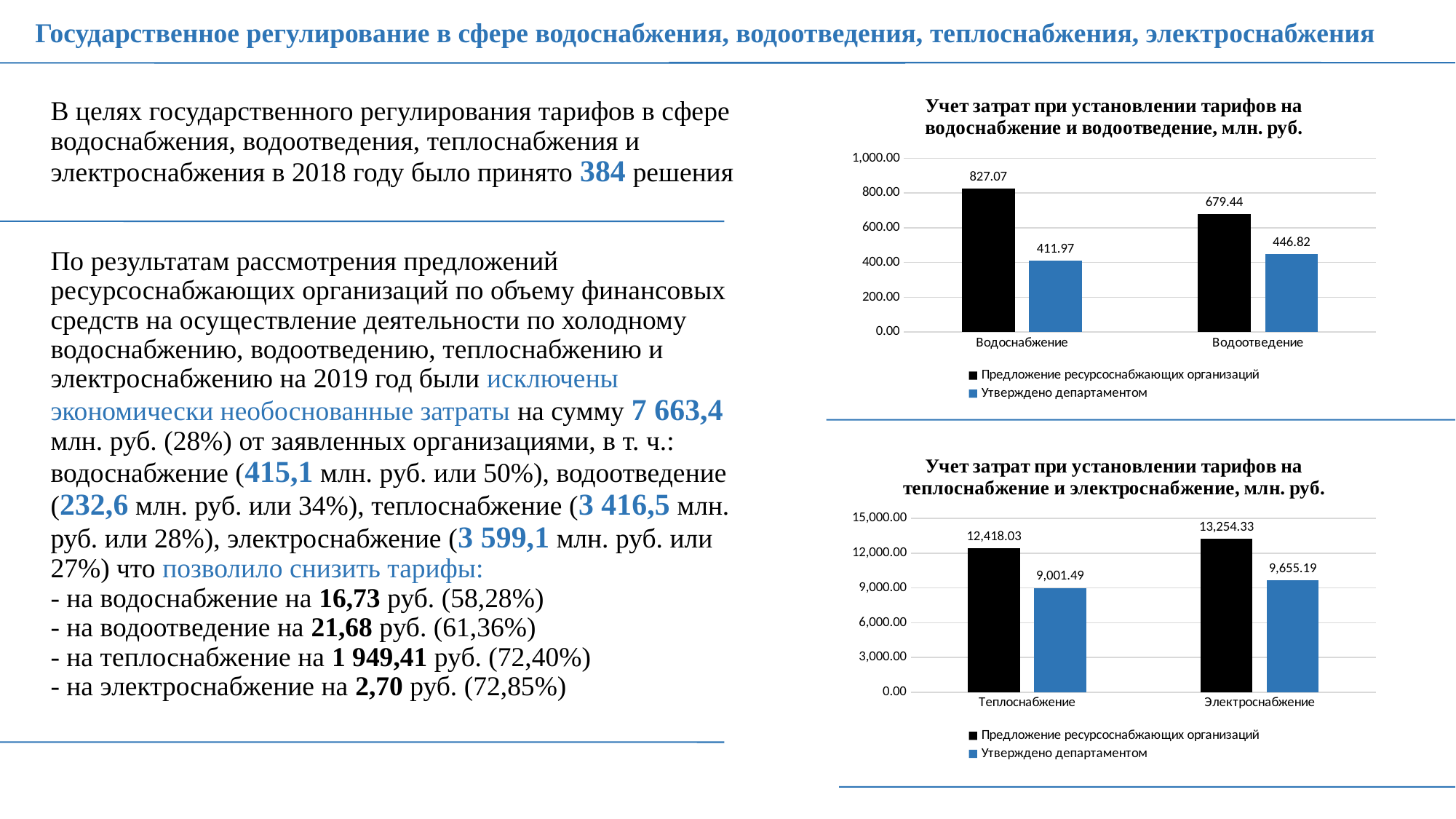
In the bottom chart (теплоснабжение и электроснабжение), which is larger: the proposed value for Теплоснабжение or the proposed value for Электроснабжение? Электроснабжение In the bottom chart (теплоснабжение и электроснабжение), what is the difference between the proposed and approved values for Электроснабжение? 3,599.14 In the bottom chart (теплоснабжение и электроснабжение), what is the value of 'Предложение ресурсоснабжающих организаций' for Электроснабжение? 13,254.33 In the top chart (водоснабжение и водоотведение), what is the value of 'Утверждено департаментом' for Водоотведение? 446.82 In the top chart (водоснабжение и водоотведение), which category has the highest 'Утверждено департаментом' value? Водоотведение In the bottom chart (теплоснабжение и электроснабжение), how many categories are shown on the x axis? 2 In the top chart (водоснабжение и водоотведение), how many series does the legend list? 2 In the bottom chart (теплоснабжение и электроснабжение), what is the value of 'Утверждено департаментом' for Теплоснабжение? 9,001.49 In the bottom chart (теплоснабжение и электроснабжение), what colour are the bars for 'Утверждено департаментом'? Blue In the top chart (водоснабжение и водоотведение), what is the value of 'Предложение ресурсоснабжающих организаций' for Водоснабжение? 827.07 In the top chart (водоснабжение и водоотведение), what type of chart is shown? Bar chart In the top chart (водоснабжение и водоотведение), what is the difference between the proposed and approved values for Водоснабжение? 415.10